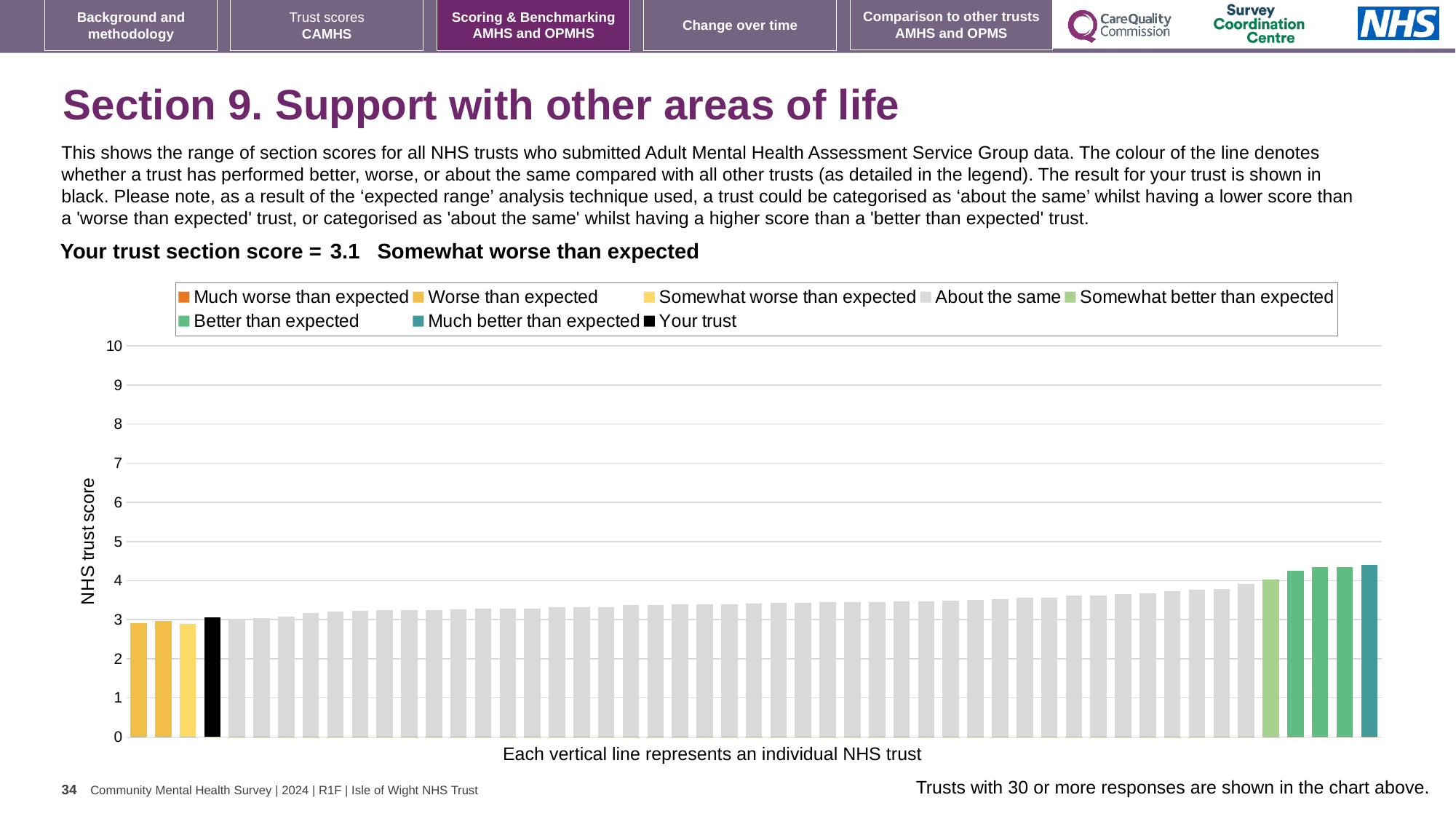
Is the value of the 'Your trust' bar greater or less than 5? less Is the value of the tallest bar in the chart greater or less than 4? greater How many entries does the chart legend list? 8 Do the bar values rise or fall from left to right across the chart? rise What kind of chart is shown on the slide? bar chart What is the label on the vertical axis of the chart? NHS trust score Which legend category does the tallest bar in the chart belong to? Much better than expected How many bars are coloured as 'Worse than expected'? 2 Which performance category is your trust placed in for this section? Somewhat worse than expected How many bars are coloured as 'Better than expected'? 3 Is the value of the tallest bar in the chart greater or less than 5? less What is the section score for your trust shown on the slide? 3.1